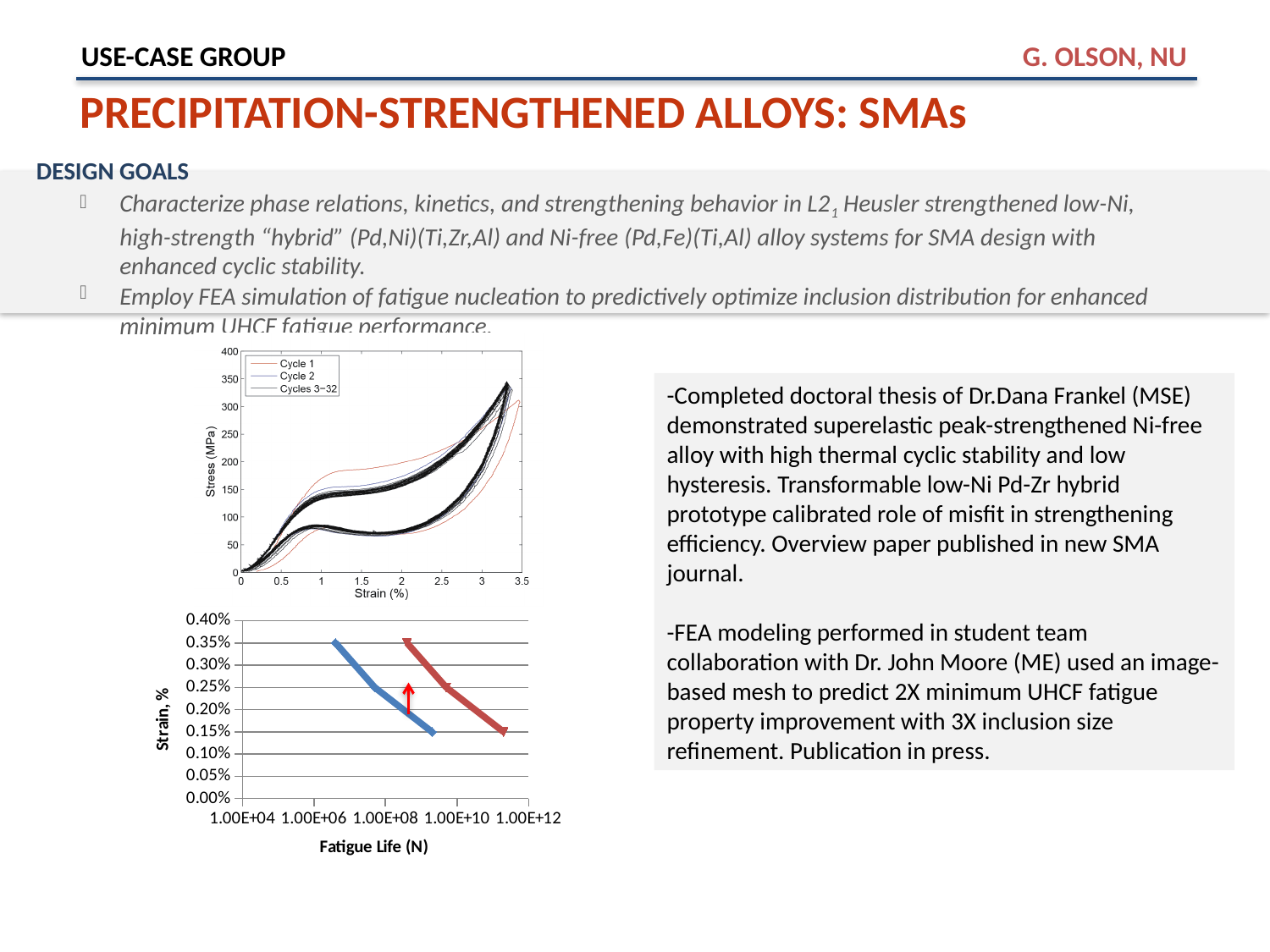
What are the legend entries in the top stress-strain chart? Cycle 1, Cycle 2, Cycles 3-32 In the top stress-strain chart, is the maximum strain reached greater or less than 3%? greater What kind of chart is the bottom chart with Fatigue Life (N) on the x axis? line chart In the bottom chart, does strain rise or fall as fatigue life increases along the x axis? fall How many data series are plotted in the bottom chart? 2 In the top stress-strain chart, is the peak stress reached greater or less than 300 MPa? greater In the bottom chart, at a strain of 0.25%, which series shows the longer fatigue life, the red or the blue? red How many series does the legend of the top stress-strain chart list? 3 In the bottom chart, is the lowest strain value of the red series greater or less than 0.20%? less What is the x-axis label of the bottom chart? Fatigue Life (N)